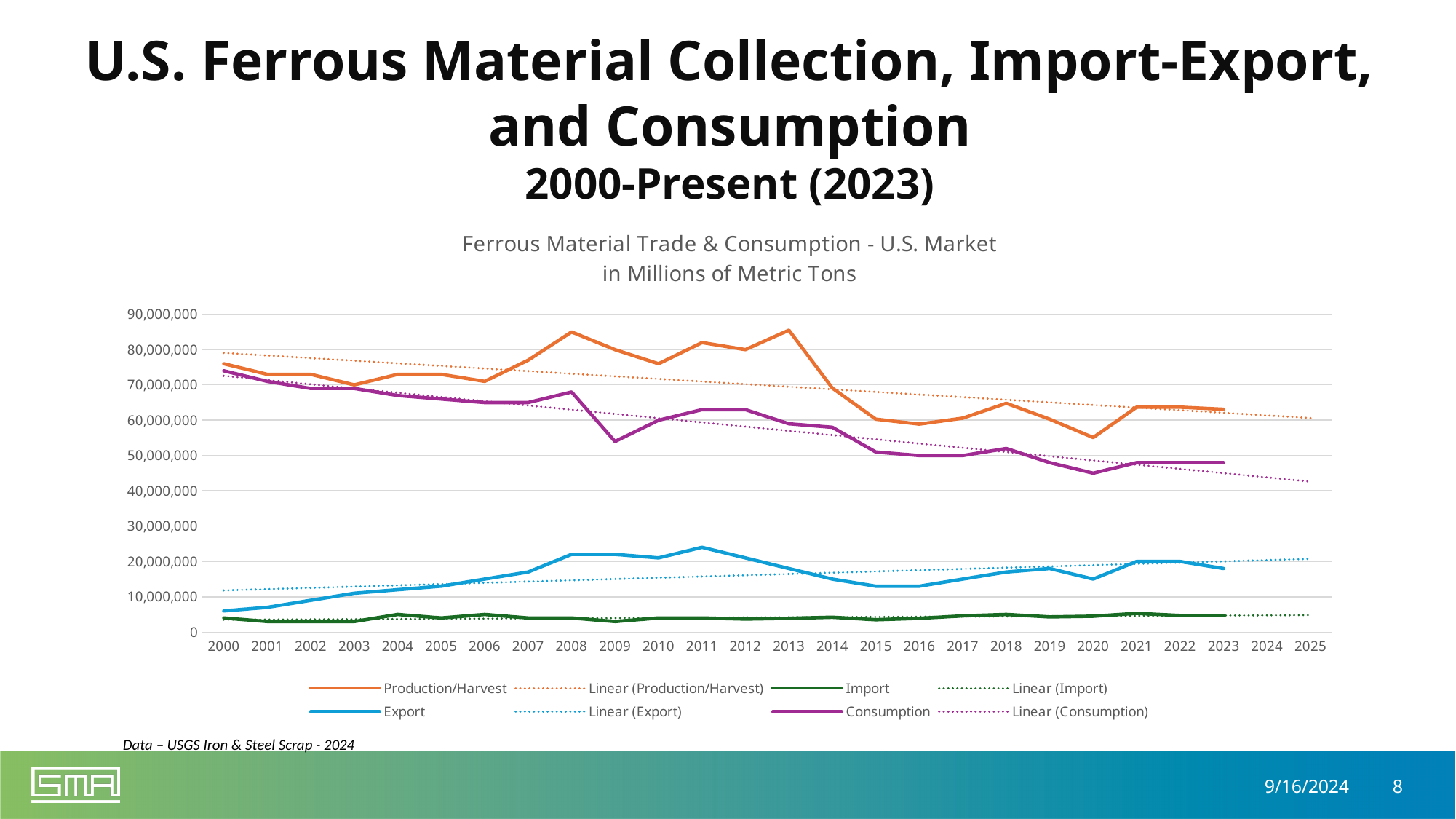
Does the Consumption line overall rise or fall from 2000 to 2023? Fall In which year does the Export line reach its highest value? 2011 In 2023, which is larger: Production/Harvest or Consumption? Production/Harvest Is the Export value for 2011 greater or less than 20,000,000? greater How many entries does the chart legend list? 8 In which year does the Consumption line reach its lowest value? 2020 Is the Production/Harvest value for 2013 greater or less than 80,000,000? greater Is the Consumption value for 2020 greater or less than 50,000,000? less How many year labels are shown along the x axis? 26 What unit does the chart subtitle say the values are in? Millions of Metric Tons What kind of chart is shown on the slide? Line chart